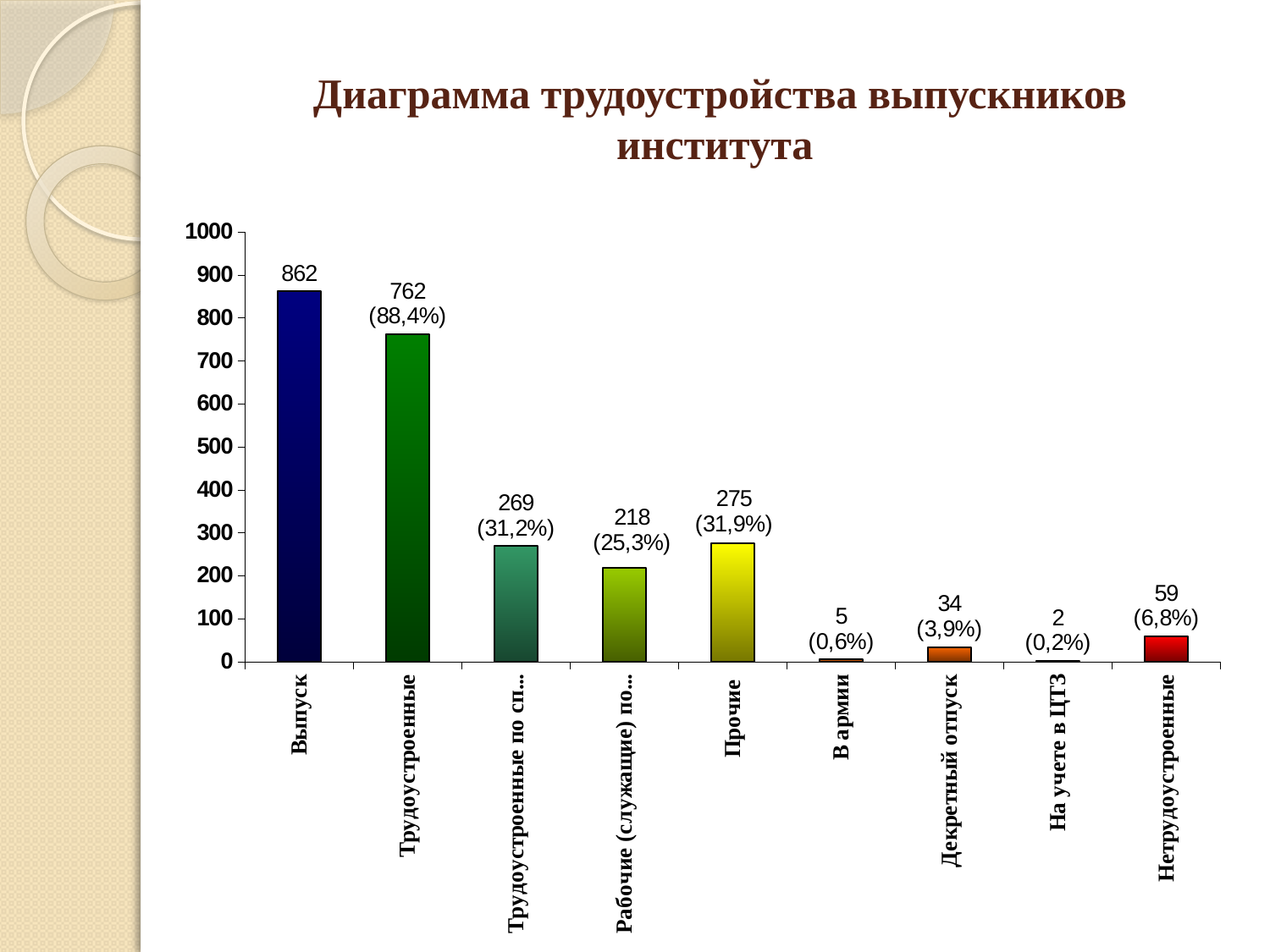
How many categories are shown on the x axis? 9 What kind of chart is shown on the slide? Bar chart What is the value for Трудоустроенные? 762 What is the value for Нетрудоустроенные? 59 What percentage is shown for В армии? 0,6% Which category has the lowest value? На учете в ЦТЗ What percentage is shown for Декретный отпуск? 3,9% What is the value for Выпуск? 862 Which is larger, the value for Прочие or the value for Декретный отпуск? Прочие What is the value for Прочие? 275 Which category has the highest value? Выпуск What is the difference between the values for Выпуск and Трудоустроенные? 100